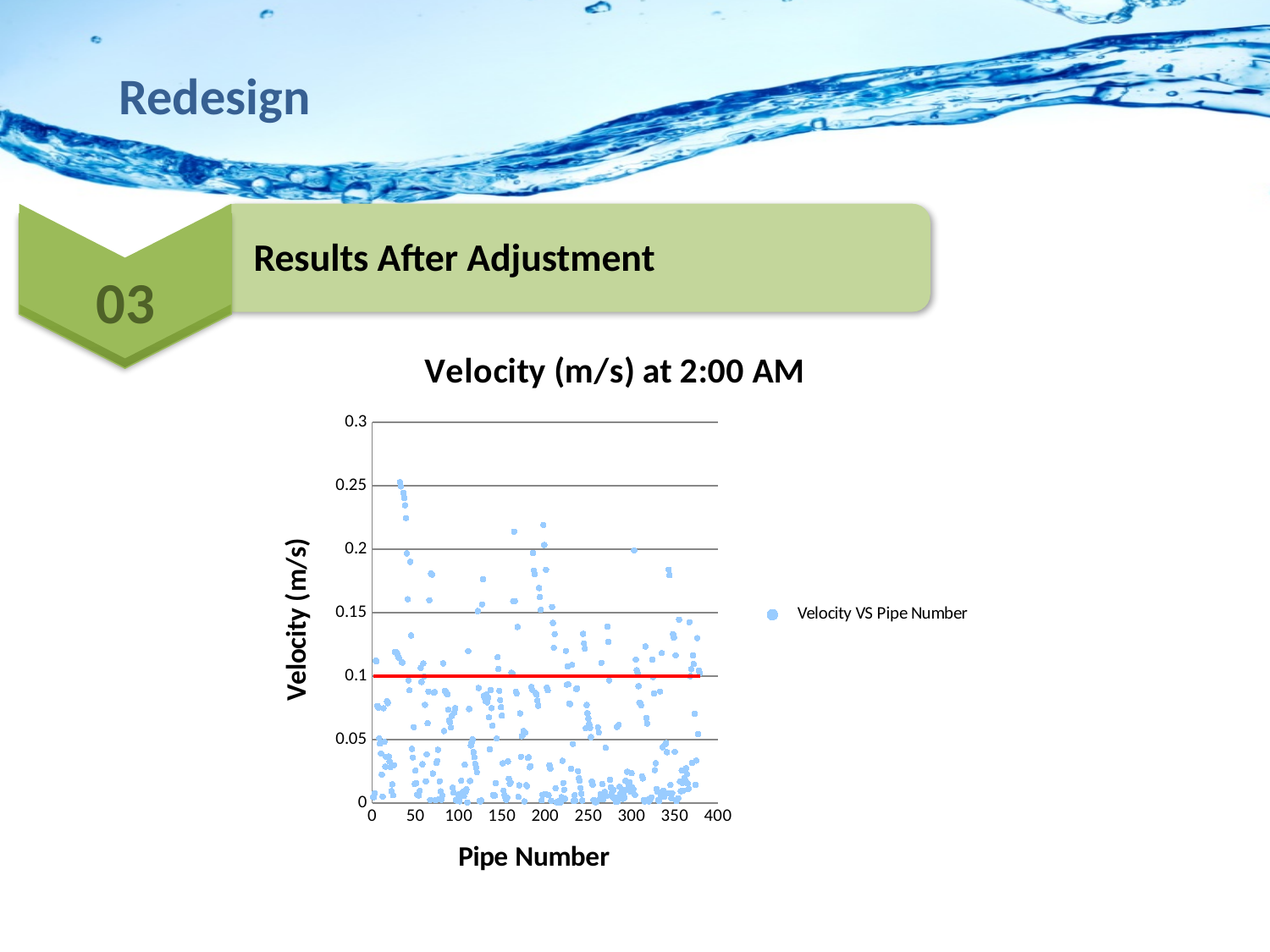
What is the highest value shown on the x axis of the chart? 400 At what velocity value is the red horizontal line drawn on the chart? 0.1 Are the plotted points mostly above or below the red line at 0.1? below What is the label of the x axis of the chart? Pipe Number What is the title of the chart? Velocity (m/s) at 2:00 AM Is the highest plotted velocity value greater or less than 0.2? greater What kind of chart is shown on the slide? Scatter chart How many series does the chart's legend list? 1 What is the highest value shown on the y axis of the chart? 0.3 Is the highest plotted velocity value greater or less than 0.3? less